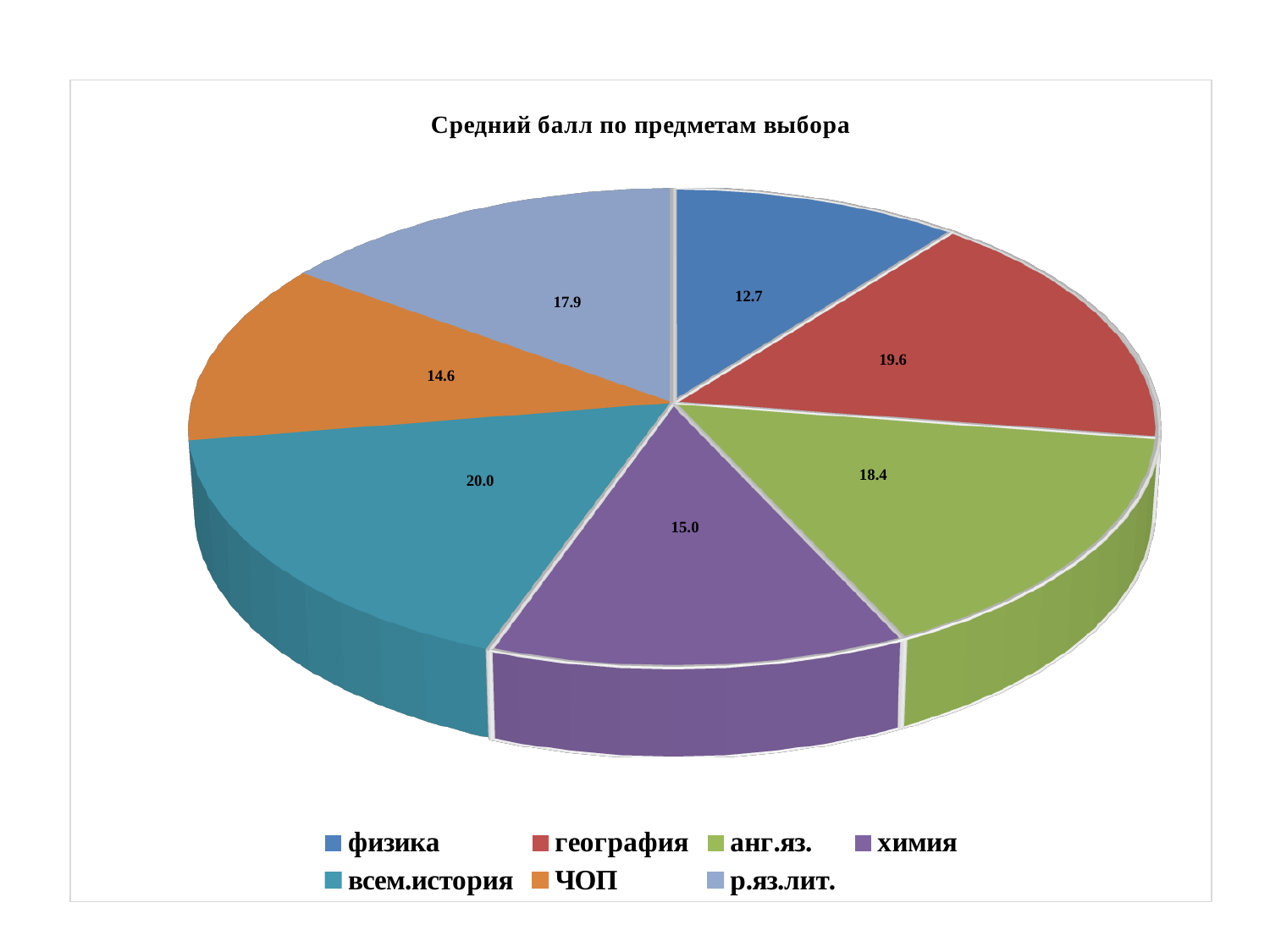
What is the title of the chart? Средний балл по предметам выбора Which subject has the lowest value in the pie chart? физика What is the difference between the values for всем.история and физика? 7.3 What is the value shown for физика? 12.7 What is the value shown for география? 19.6 What is the difference between the values for география and анг.яз.? 1.2 What is the value shown for ЧОП? 14.6 How many subjects (slices) are shown in the pie chart? 7 Which subject has the highest value in the pie chart? всем.история Which is larger, the value for химия or the value for р.яз.лит.? р.яз.лит. What is the value shown for всем.история? 20.0 What kind of chart is shown on the slide? Pie chart